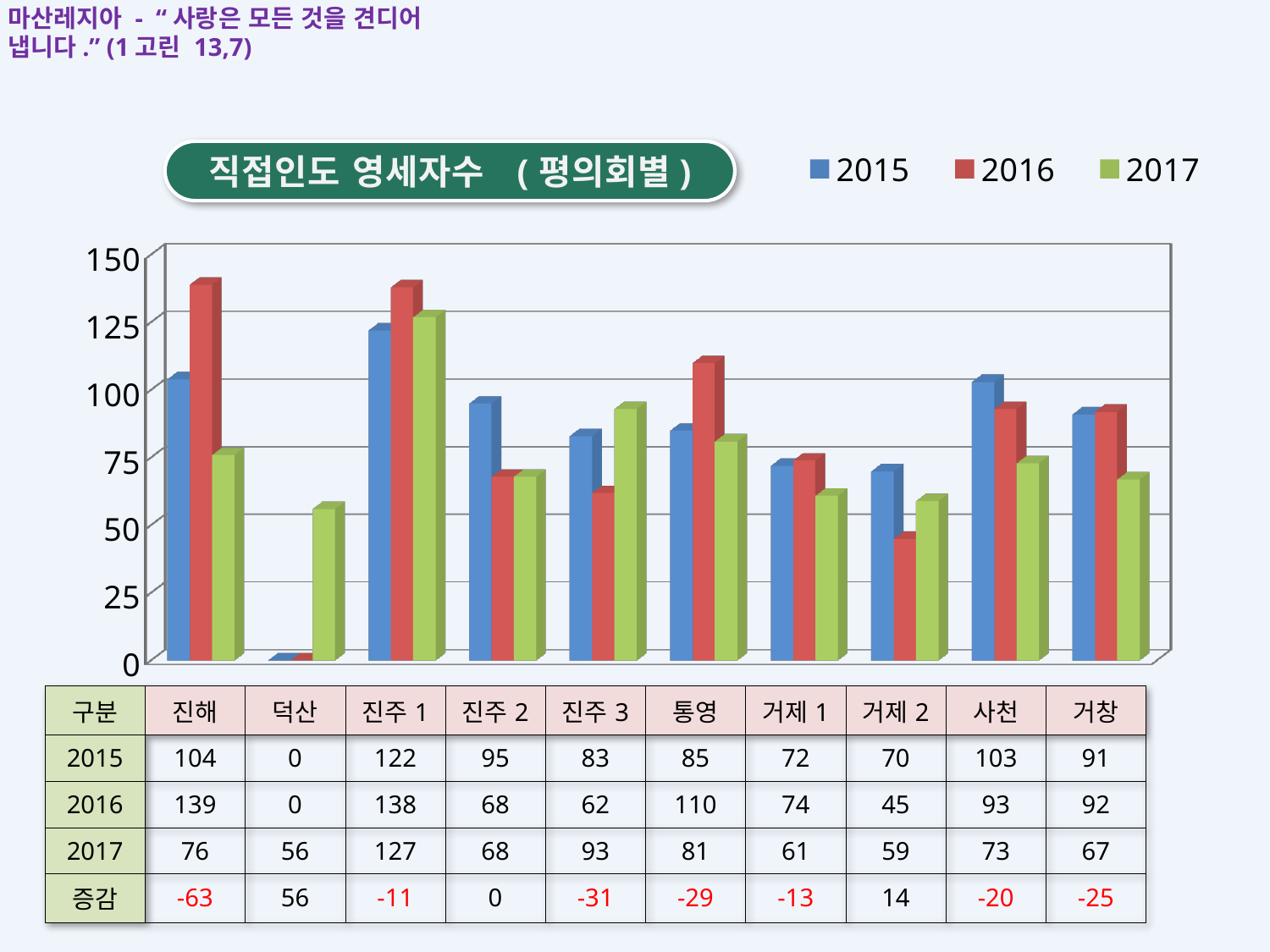
What type of chart is shown on the slide? bar chart What is the 2015 value for 사천? 103 Which category has the lowest 2015 value? 덕산 What is the difference between the 2016 and 2017 values for 진해? 63 Which category has the highest 2017 value? 진주 1 Which is larger for 통영: the 2016 value or the 2015 value? 2016 What is the title of the chart? 직접인도 영세자수 (평의회별) How many categories (평의회) are shown along the x axis? 10 What is the 2017 value for 진주 1? 127 What is the 2016 value for 진해? 139 Is the 2016 value for 거제 2 greater or less than 50? less How many series does the legend list? 3